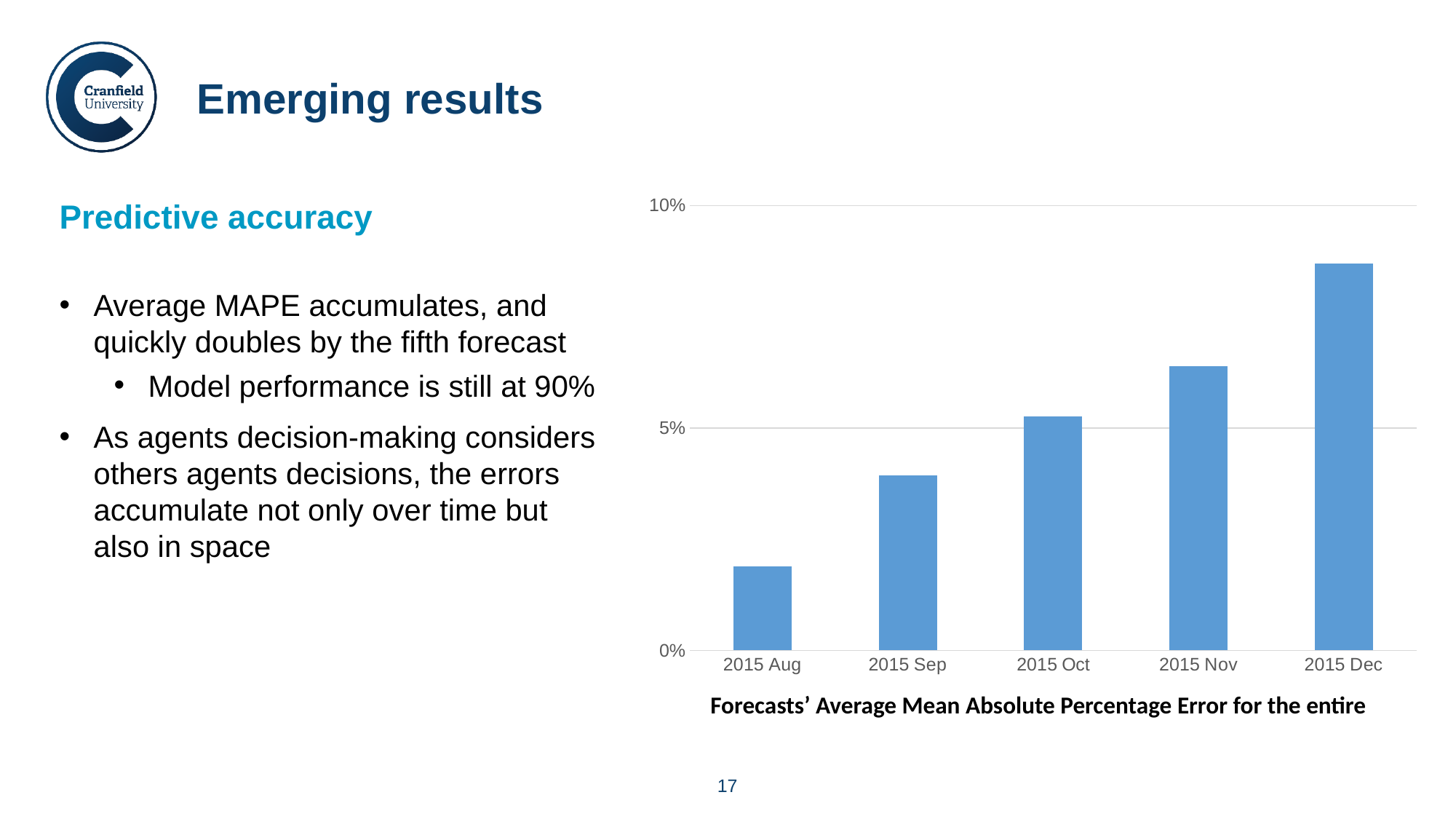
Which is larger, the value for 2015 Nov or the value for 2015 Sep? 2015 Nov Which month has the highest bar in the chart? 2015 Dec Is the value for 2015 Dec greater or less than 5%? greater What kind of chart is shown on the slide? bar chart Is the value for 2015 Aug greater or less than 5%? less How many categories are shown on the x axis of the chart? 5 Is the value for 2015 Sep greater or less than 5%? less What is the first category label on the x axis of the chart? 2015 Aug Do the values rise or fall from 2015 Aug to 2015 Dec? rise Which month has the lowest bar in the chart? 2015 Aug